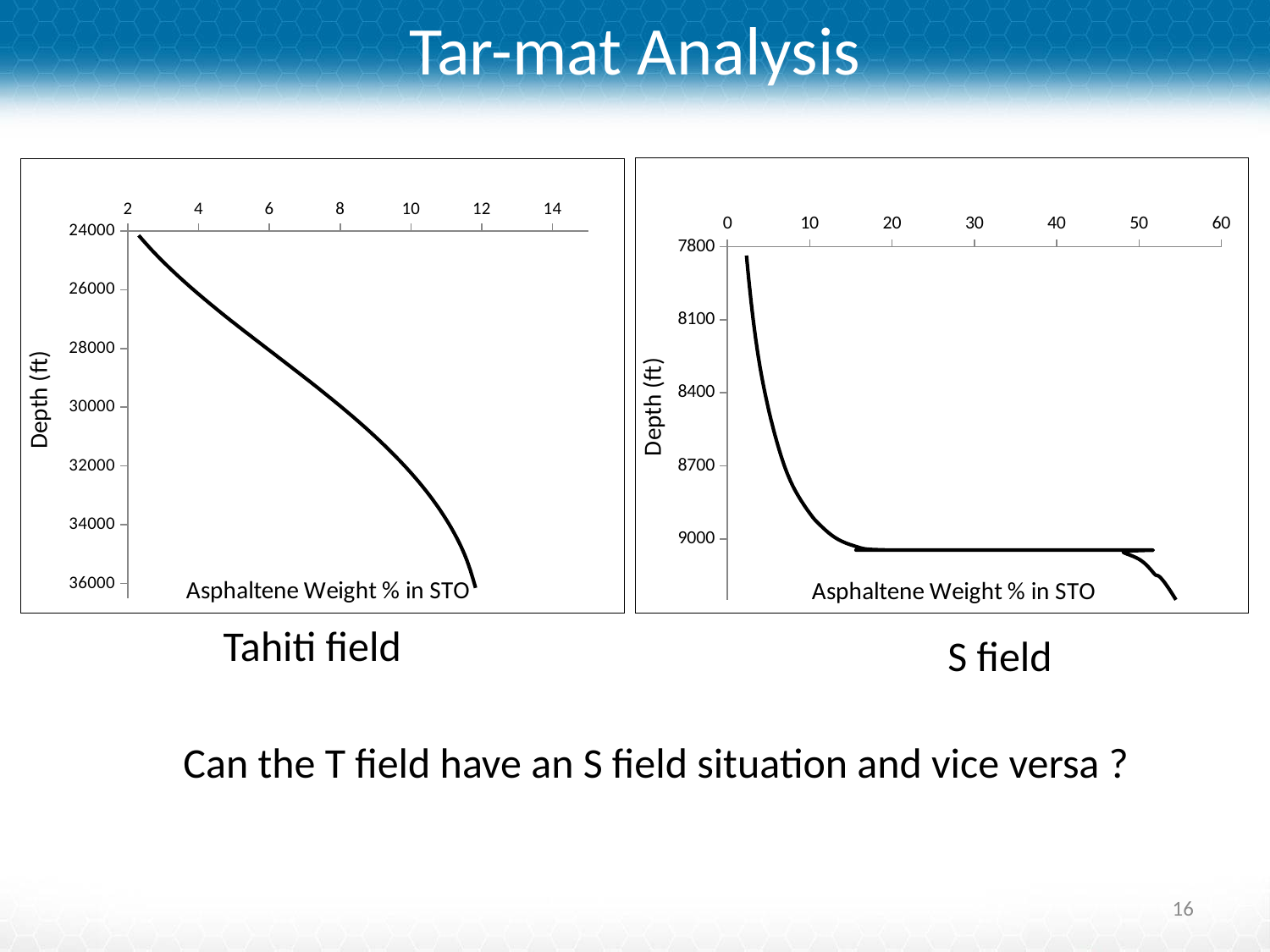
In the Tahiti field chart, is the asphaltene weight % at a depth of 26000 ft greater or less than 6? less What kind of chart is the Tahiti field chart? line chart In the S field chart, what quantity is plotted on the horizontal axis? Asphaltene Weight % in STO In the S field chart, what is the largest value shown on the horizontal axis? 60 In the S field chart, does the asphaltene weight % increase or decrease as depth increases from 7800 ft toward 9000 ft? increase In the S field chart, is the asphaltene weight % at a depth of 8400 ft greater or less than 10? less In the Tahiti field chart, what is the label of the vertical axis? Depth (ft) In the Tahiti field chart, does the asphaltene weight % increase or decrease as depth increases from 24000 ft to 36000 ft? increase What kind of chart is the S field chart? line chart In the S field chart, is the highest asphaltene weight % reached by the curve greater or less than 50? greater How many charts are shown on the slide? 2